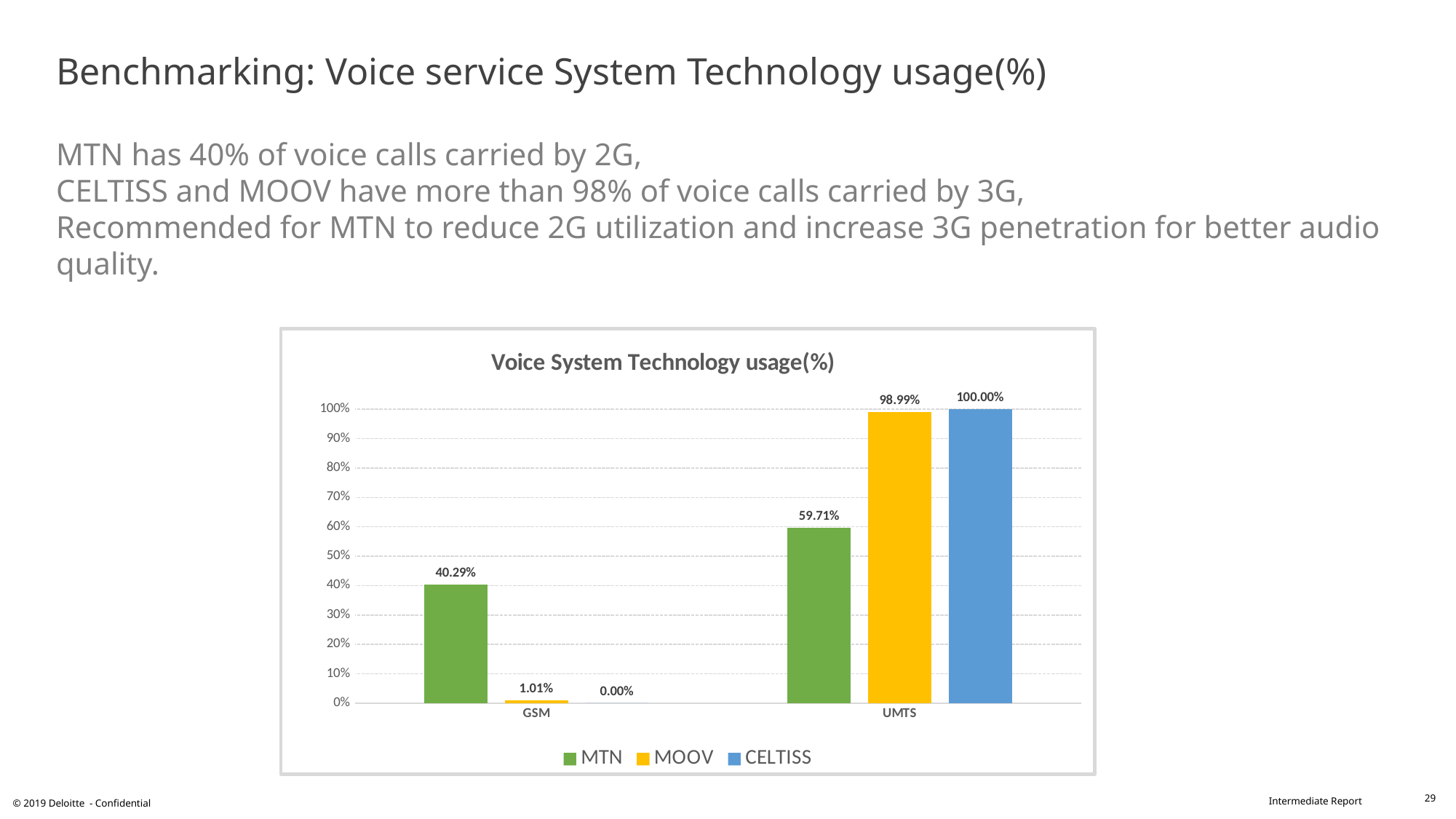
What is the difference between the MTN values for UMTS and GSM? 19.42% What is the value for MOOV in the UMTS category? 98.99% What is the value for MTN in the GSM category? 40.29% Which operator has the highest value in the UMTS category? CELTISS Is the value for MTN in the UMTS category greater or less than 50%? greater What is the value for CELTISS in the GSM category? 0.00% How many series does the legend list? 3 What kind of chart is shown on the slide? Bar chart What is the title of the chart? Voice System Technology usage(%) Which operator has the lowest value in the GSM category? CELTISS What is the value for MTN in the UMTS category? 59.71% Which is larger: MOOV's GSM value or MTN's GSM value? MTN's GSM value